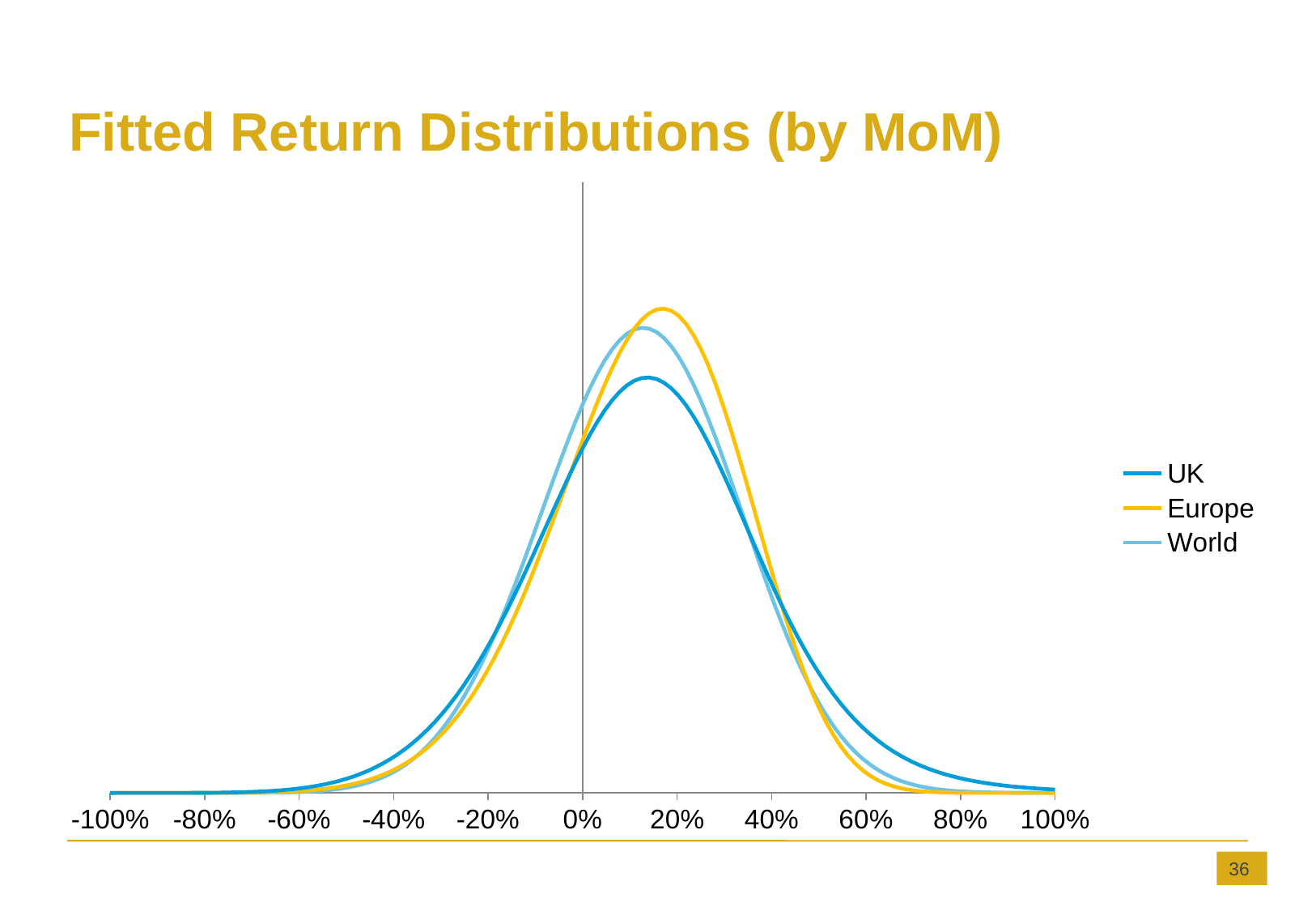
Which series has the lowest peak? UK What is the title of the chart on the slide? Fitted Return Distributions (by MoM) What kind of chart is shown on the slide? Line chart Which curve reaches a higher peak, Europe or World? Europe Which curve reaches a higher peak, UK or World? World What is the leftmost tick label on the x axis? -100% Is the x-value at which the Europe curve peaks greater or less than 0%? greater Is the x-value at which the UK curve peaks greater or less than 40%? less How many tick labels are shown on the x axis? 11 How many series does the legend list? 3 Which series has the highest peak? Europe Which series are listed in the legend? UK, Europe, World